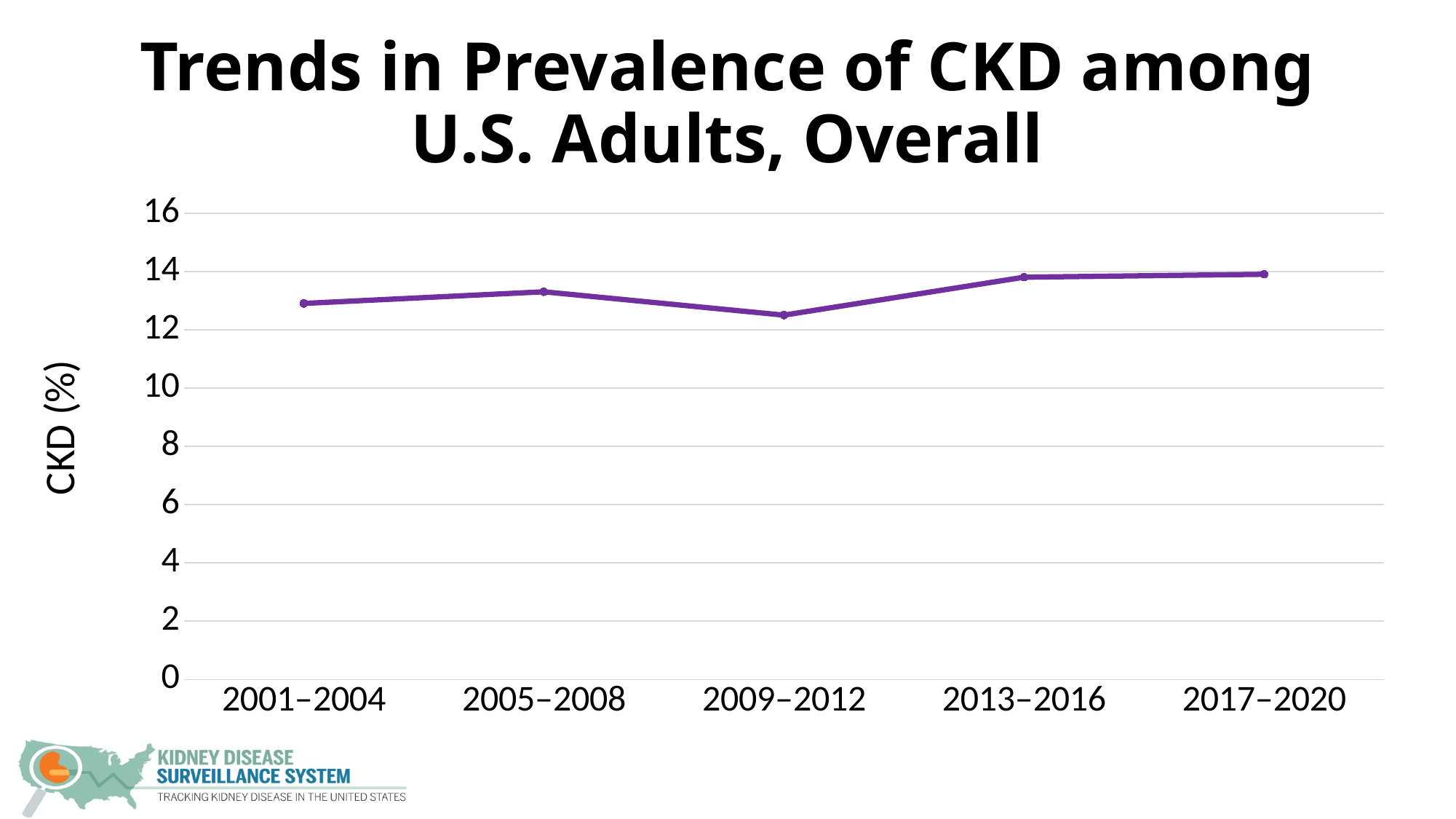
What is the label on the y axis? CKD (%) How many time periods are plotted on the x axis? 5 Does the CKD prevalence rise or fall from 2009–2012 to 2013–2016? Rise Which time period has the lowest CKD prevalence? 2009–2012 Which is larger, the value for 2005–2008 or the value for 2009–2012? 2005–2008 Is the value for 2005–2008 greater or less than 14? less Which is larger, the value for 2001–2004 or the value for 2013–2016? 2013–2016 Is the value for 2017–2020 greater or less than 16? less Does the CKD prevalence rise or fall from 2005–2008 to 2009–2012? Fall Is the value for 2009–2012 greater or less than 10? greater What kind of chart is shown on the slide? Line chart